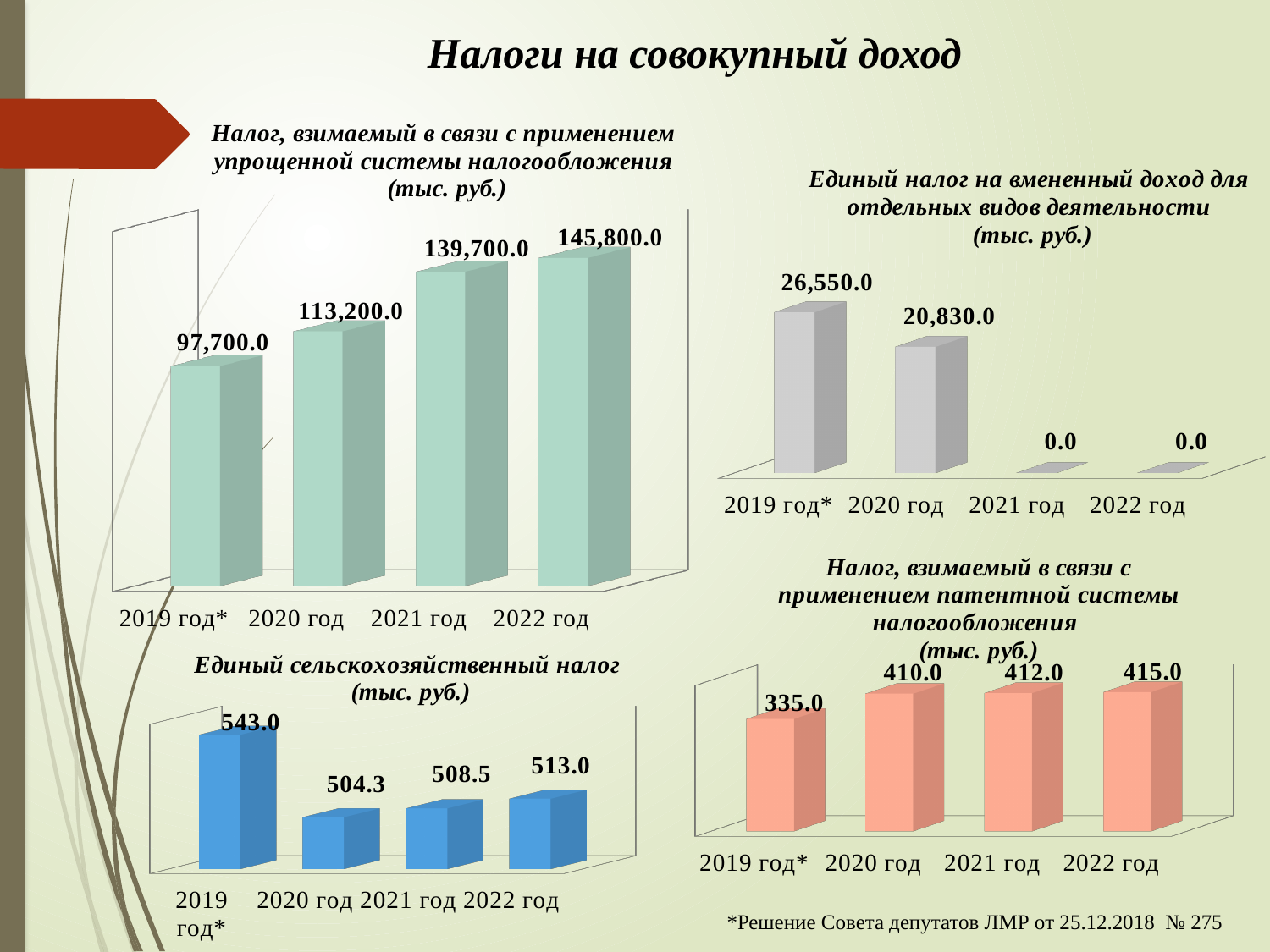
In the top-right chart (Единый налог на вмененный доход), what is the difference between the 2019 год* and 2020 год values? 5,720.0 In the top-right chart (Единый налог на вмененный доход), what is the value for 2020 год? 20,830.0 In the top-right chart (Единый налог на вмененный доход), how many years are shown on the x axis? 4 In the bottom-right chart (патентная система налогообложения), which is larger: the value for 2019 год* or 2022 год? 2022 год What type of chart is the bottom-right chart (патентная система налогообложения)? bar chart In the top-left chart (упрощенная система налогообложения), which year has the lowest value? 2019 год* In the top-left chart (упрощенная система налогообложения), what is the value for 2021 год? 139,700.0 In the bottom-left chart (Единый сельскохозяйственный налог), which year has the highest value? 2019 год* In the top-left chart (упрощенная система налогообложения), do the values rise or fall from 2019 to 2022? rise In the top-left chart (упрощенная система налогообложения), what is the difference between the 2022 год and 2019 год* values? 48,100.0 In the bottom-left chart (Единый сельскохозяйственный налог), what is the value for 2021 год? 508.5 In the bottom-left chart (Единый сельскохозяйственный налог), what is the difference between the 2019 год* and 2020 год values? 38.7